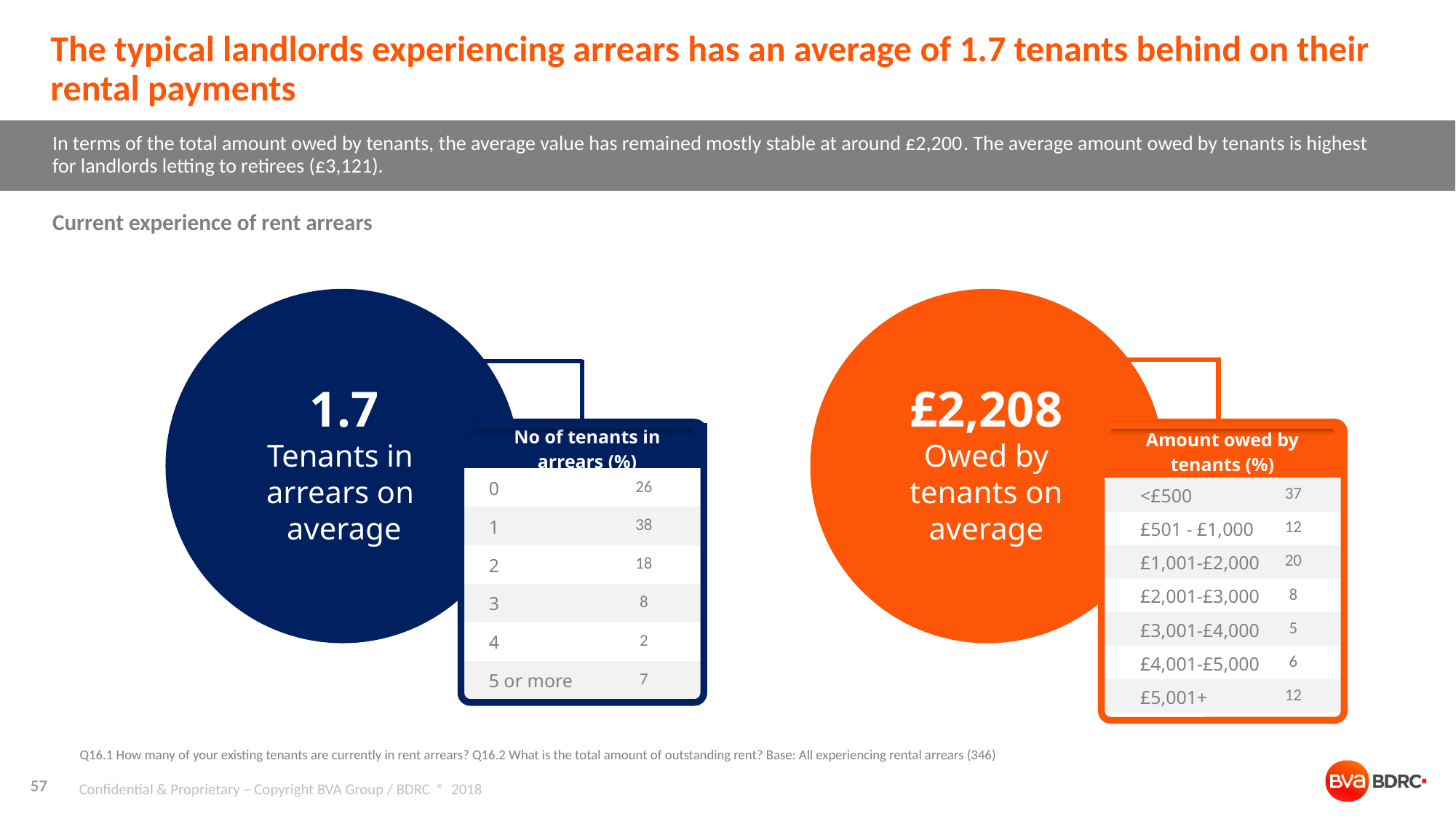
In the 'No of tenants in arrears (%)' table, what percentage of landlords have 5 or more tenants in arrears? 7 In the 'Amount owed by tenants (%)' table, which category has the lowest percentage? £3,001-£4,000 In the 'No of tenants in arrears (%)' table, what percentage of landlords have 1 tenant in arrears? 38 In the 'No of tenants in arrears (%)' table, what is the difference between the percentages for 0 tenants and 2 tenants? 8 In the 'No of tenants in arrears (%)' table, which category has the lowest percentage? 4 In the 'Amount owed by tenants (%)' table, what percentage is shown for £1,001-£2,000? 20 How many categories are listed in the 'Amount owed by tenants (%)' table? 7 In the 'Amount owed by tenants (%)' table, what percentage is shown for <£500? 37 In the 'No of tenants in arrears (%)' table, which category has the highest percentage? 1 How many categories are listed in the 'No of tenants in arrears (%)' table? 6 In the 'Amount owed by tenants (%)' table, which is larger: the percentage for £501 - £1,000 or for £2,001-£3,000? £501 - £1,000 What average amount owed by tenants is shown in the orange circle? £2,208